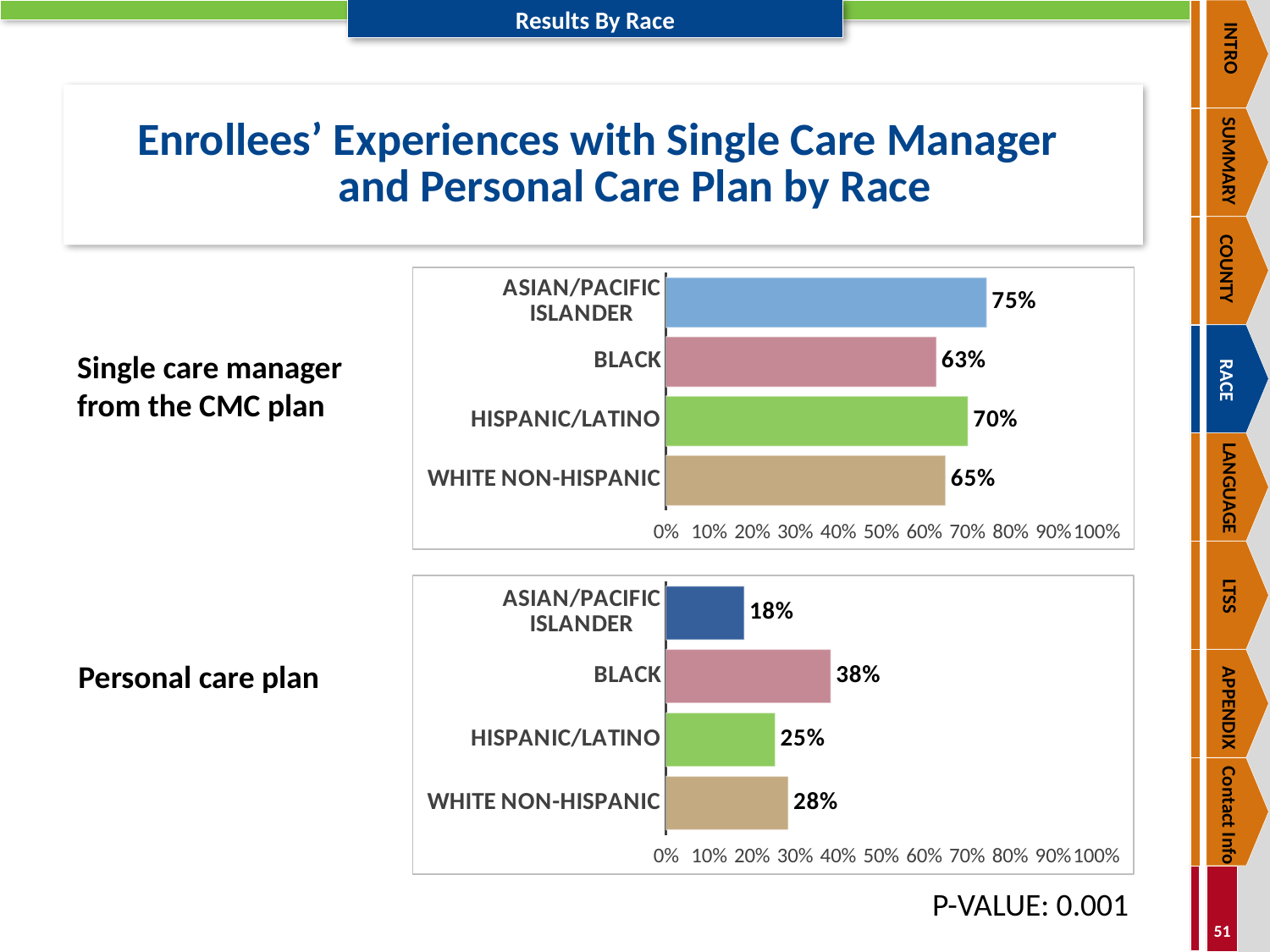
How many categories are shown in the 'Personal care plan' chart? 4 In the 'Single care manager from the CMC plan' chart, which category has the lowest value? Black In the 'Single care manager from the CMC plan' chart, which category has the highest value? Asian/Pacific Islander In the 'Single care manager from the CMC plan' chart, what is the value for Black? 63% In the 'Personal care plan' chart, which category has the highest value? Black In the 'Personal care plan' chart, which category has the lowest value? Asian/Pacific Islander What kind of chart is the 'Single care manager from the CMC plan' chart? Bar chart In the 'Single care manager from the CMC plan' chart, what is the value for Asian/Pacific Islander? 75% In the 'Personal care plan' chart, what is the value for White Non-Hispanic? 28% In the 'Personal care plan' chart, what is the value for Hispanic/Latino? 25% In the 'Personal care plan' chart, which is larger, the value for Black or the value for White Non-Hispanic? Black In the 'Single care manager from the CMC plan' chart, what is the difference between the values for Hispanic/Latino and White Non-Hispanic? 5%